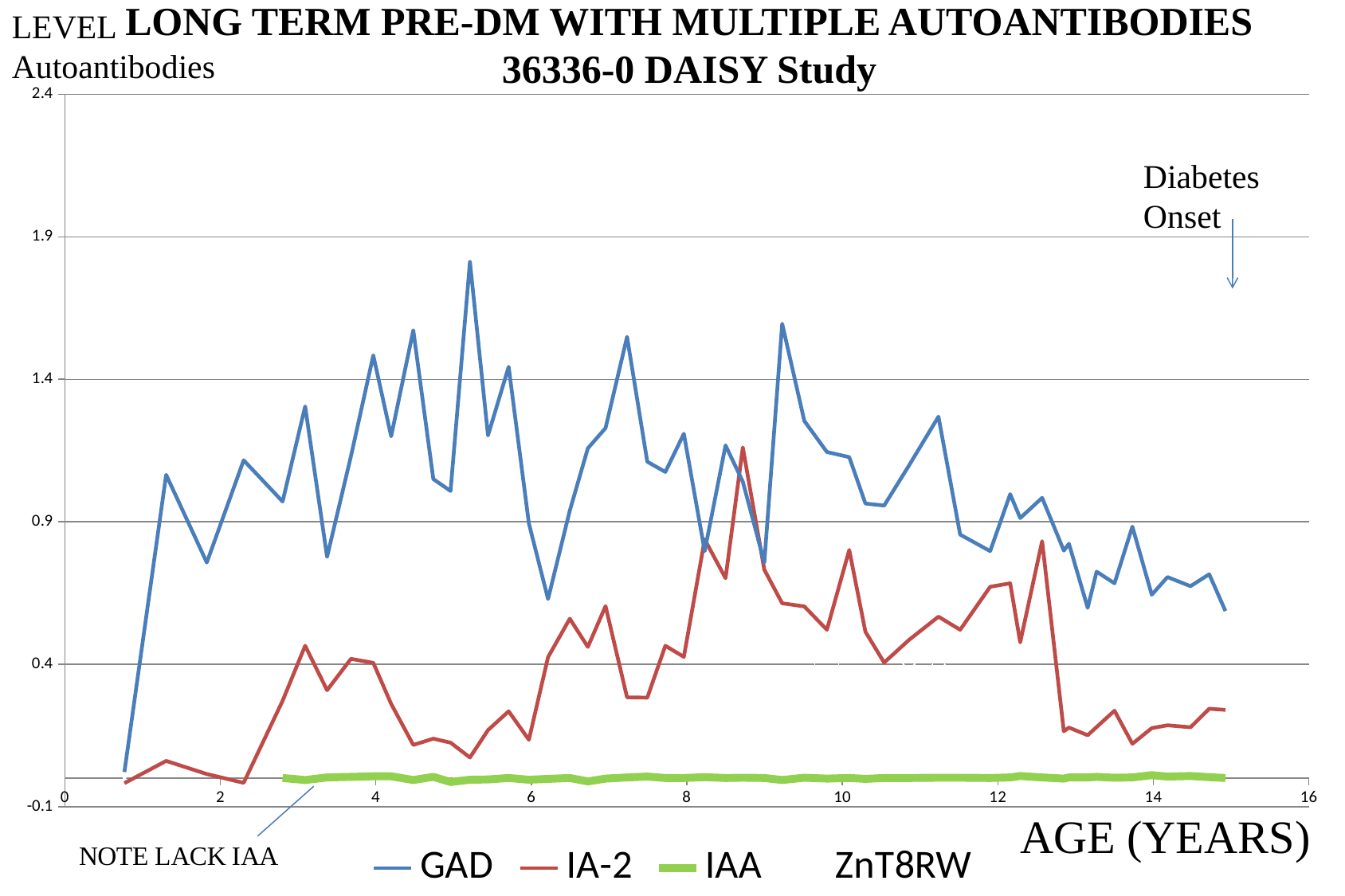
How many series does the legend list? 4 Is the value of the IA-2 series at age 13 greater or less than 0.4? less At age 4, which series has the larger value, GAD or IA-2? GAD What kind of chart is shown on the slide? Line chart Is the peak value of the GAD series (around age 5) greater or less than 1.4? greater What event does the arrow near age 15 mark? Diabetes Onset Is the peak value of the IA-2 series (around age 8.7) greater or less than 0.9? greater What is the label of the x axis? AGE (YEARS) Which series stays lowest across the whole age range? IAA Does the GAD series generally rise or fall between age 10 and age 15? fall Which series reaches the highest value on the chart? GAD